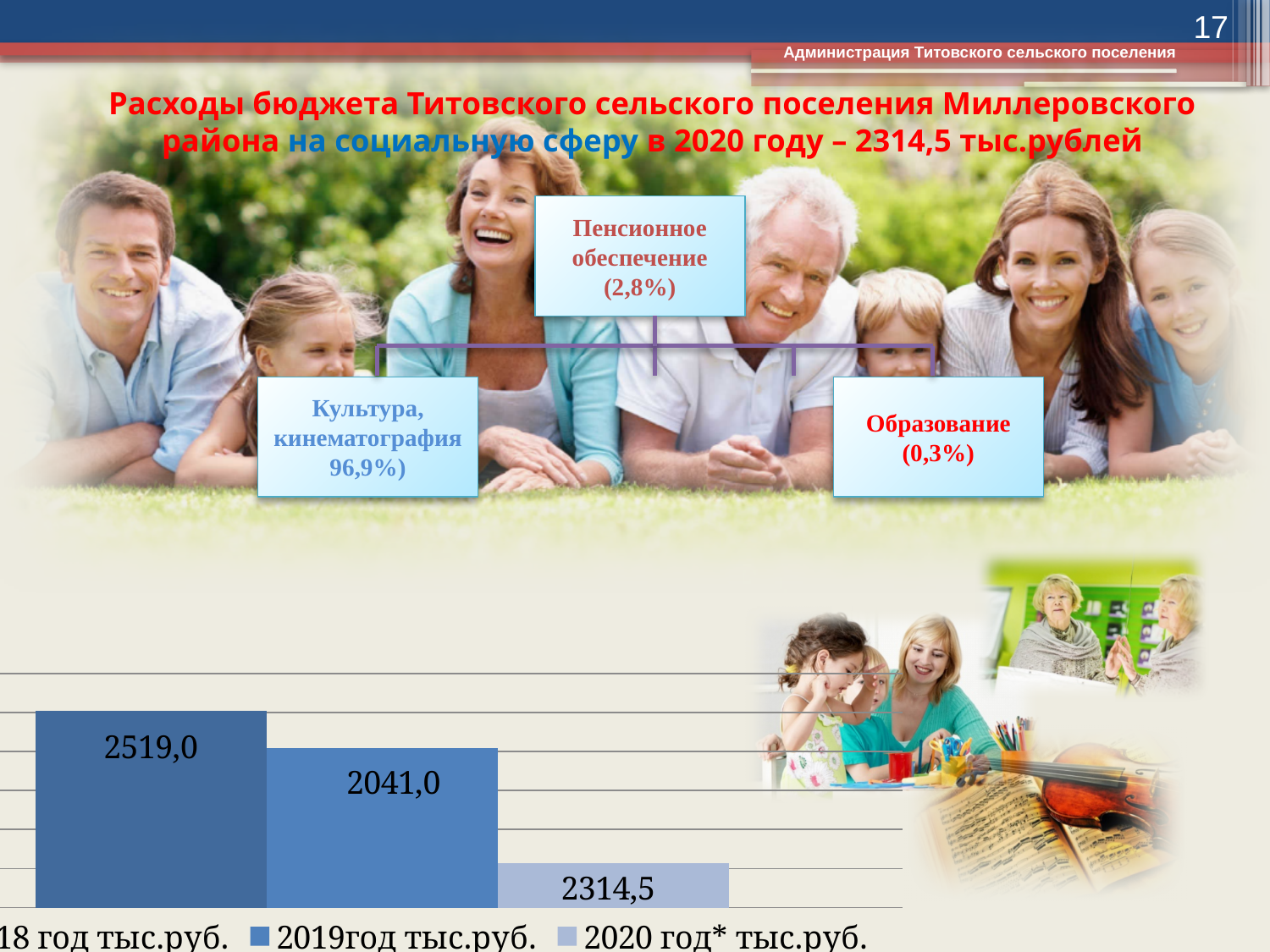
What is the value of the bar for 2020 (2020 год* тыс.руб.)? 2314,5 What is the difference between the leftmost bar (2519,0) and the 2019 bar? 478,0 How many bars are plotted in the chart? 3 How many series does the legend of the bar chart list? 3 What is the value of the bar for 2019 (2019год тыс.руб.)? 2041,0 Which bar in the chart is the tallest: the leftmost, the middle, or the rightmost? leftmost What is the value of the leftmost (dark blue) bar in the chart? 2519,0 What is the difference between the 2020 value and the 2019 value in the bar chart? 273,5 What kind of chart is shown at the bottom of the slide? bar chart